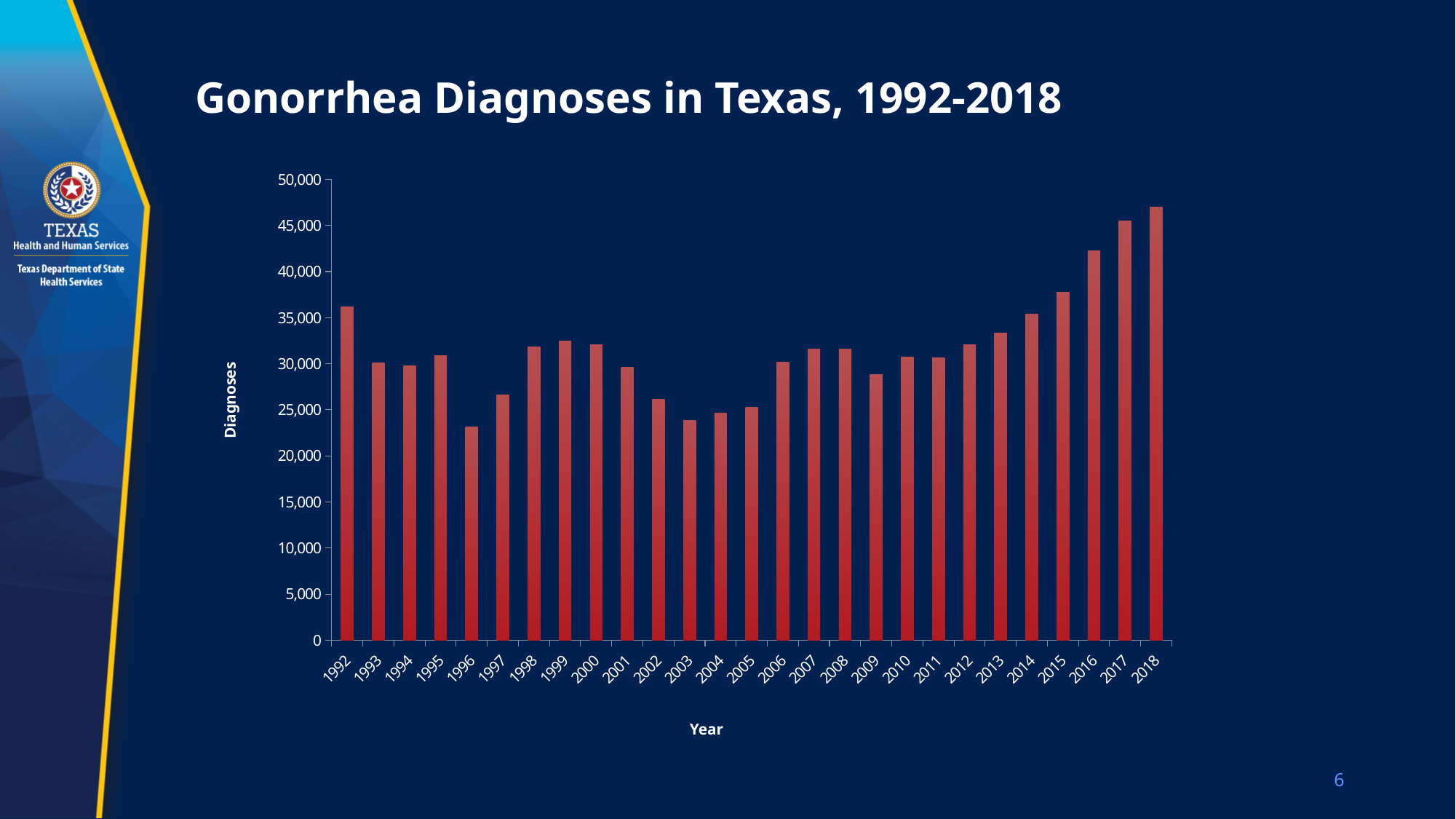
How many years are plotted on the x axis of the chart? 27 Which year has more diagnoses, 2006 or 2016? 2016 What is the title of the chart? Gonorrhea Diagnoses in Texas, 1992-2018 Is the value for 1996 greater or less than 25,000? less Is the value for 2009 greater or less than 30,000? less What is the label on the vertical axis of the chart? Diagnoses Is the value for 2016 greater or less than 40,000? greater Which year has the highest number of gonorrhea diagnoses? 2018 What kind of chart is shown on the slide? Bar chart Which year has more diagnoses, 1992 or 1996? 1992 Do the diagnoses rise or fall from 2013 to 2018? Rise